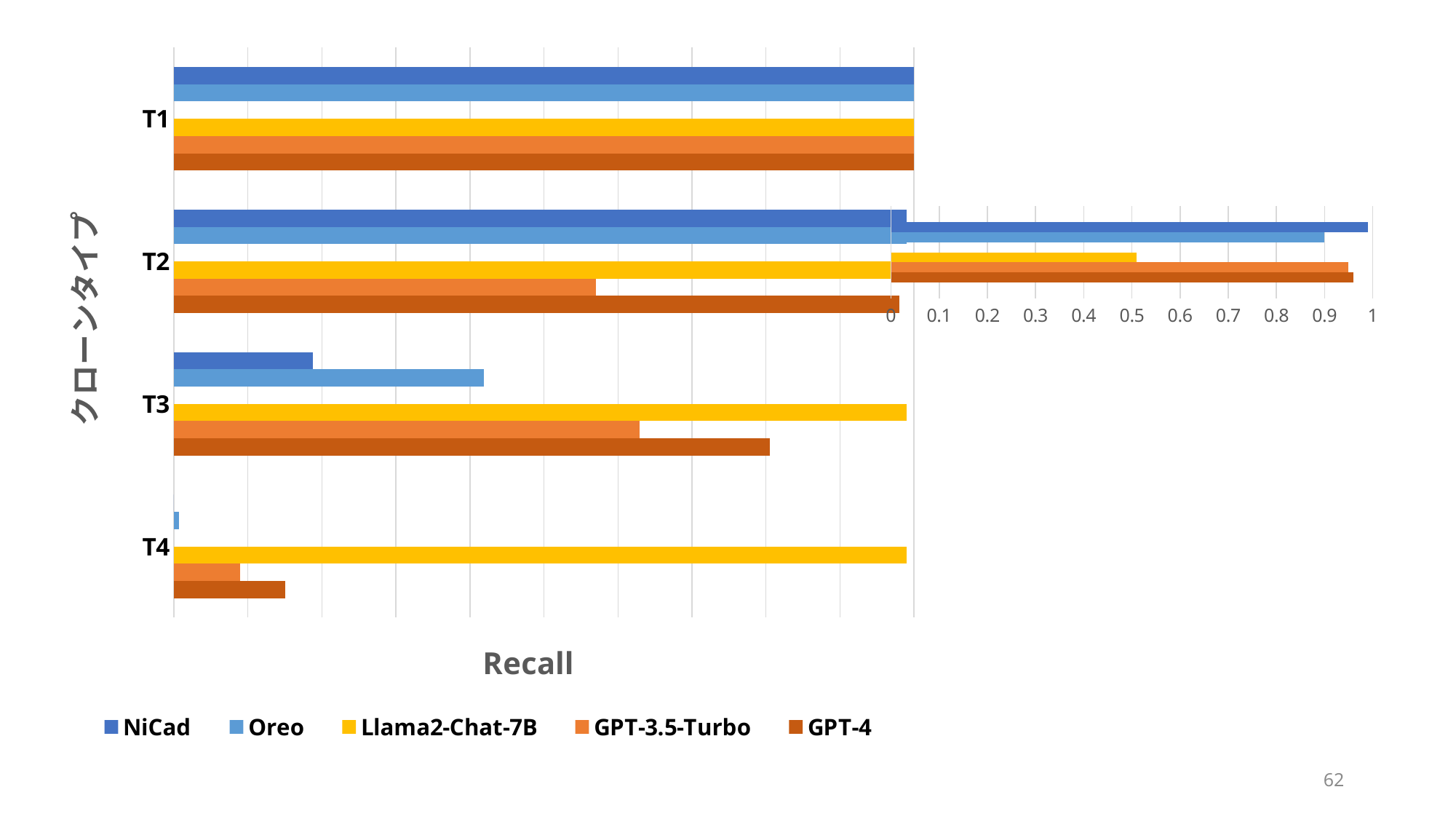
In the main chart, do the values for NiCad rise or fall going from T1 to T4? fall How many clone-type categories are shown on the y axis of the main chart? 4 In the main chart, for T3, which is larger: the value for Oreo or the value for NiCad? Oreo Which series is listed first in the legend of the main chart? NiCad In the main chart, for T3, which is larger: the value for GPT-4 or the value for GPT-3.5-Turbo? GPT-4 What kind of chart is shown on the slide? bar chart In the main chart, which series has the lowest value for T2? GPT-3.5-Turbo What is the title of the x axis of the main chart? Recall In the main chart, which series has the highest value for T3? Llama2-Chat-7B In the main chart, which series has the highest value for T4? Llama2-Chat-7B In the main chart, which series has the lowest value for T3? NiCad How many series does the legend of the main chart list? 5